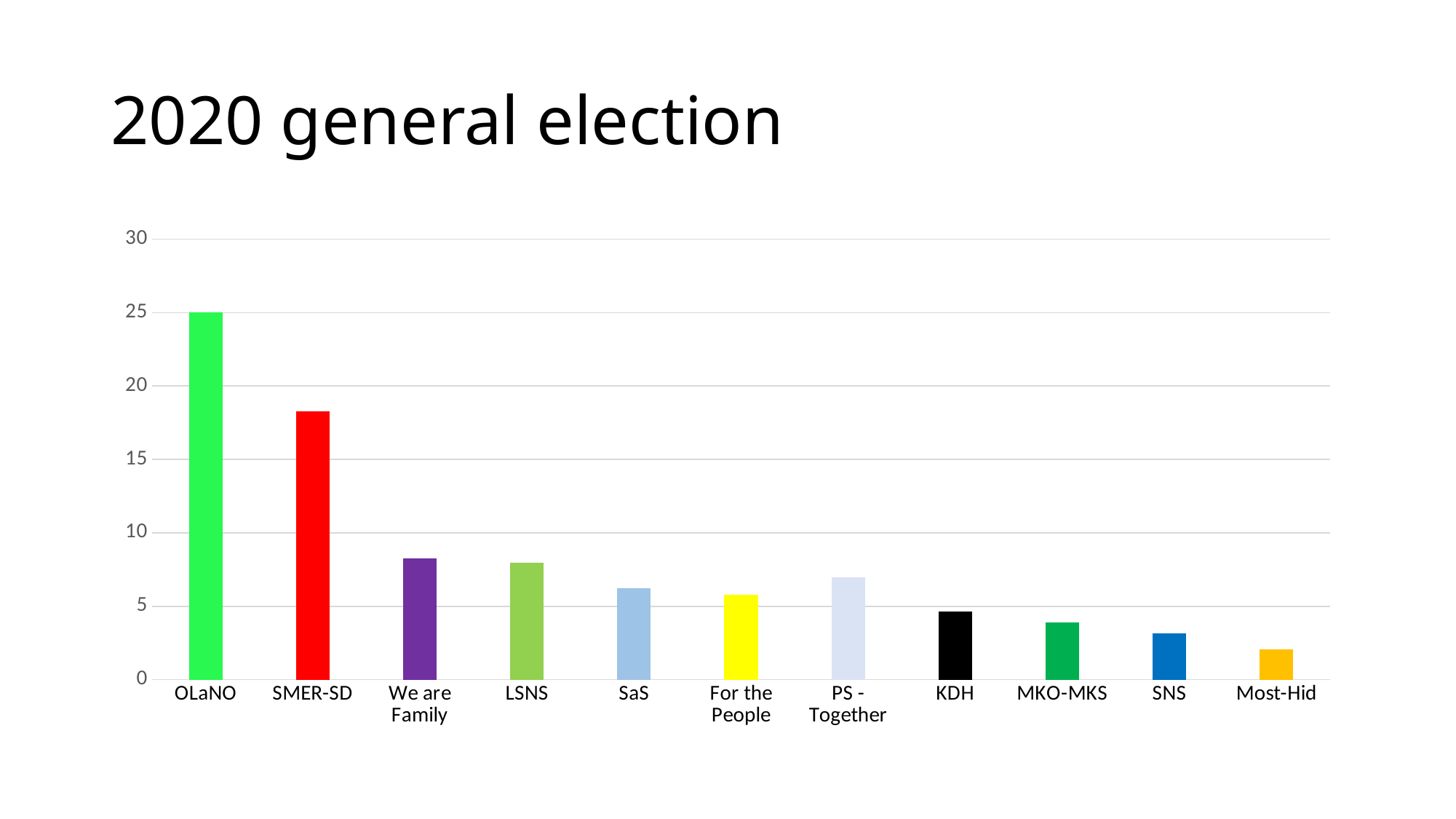
Is the value for LSNS greater or less than 10? less What colour is the bar for OLaNO? green Which party has the lowest bar on the chart? Most-Hid What kind of chart is shown on the slide? bar chart How many parties (categories) are shown on the chart? 11 Do the values generally rise or fall moving from left to right along the x axis? fall Which party has the highest bar on the chart? OLaNO What is the value for OLaNO? 25 Is the value for KDH greater or less than 5? less Which is larger, the value for SMER-SD or the value for We are Family? SMER-SD Is the value for SMER-SD greater or less than 15? greater